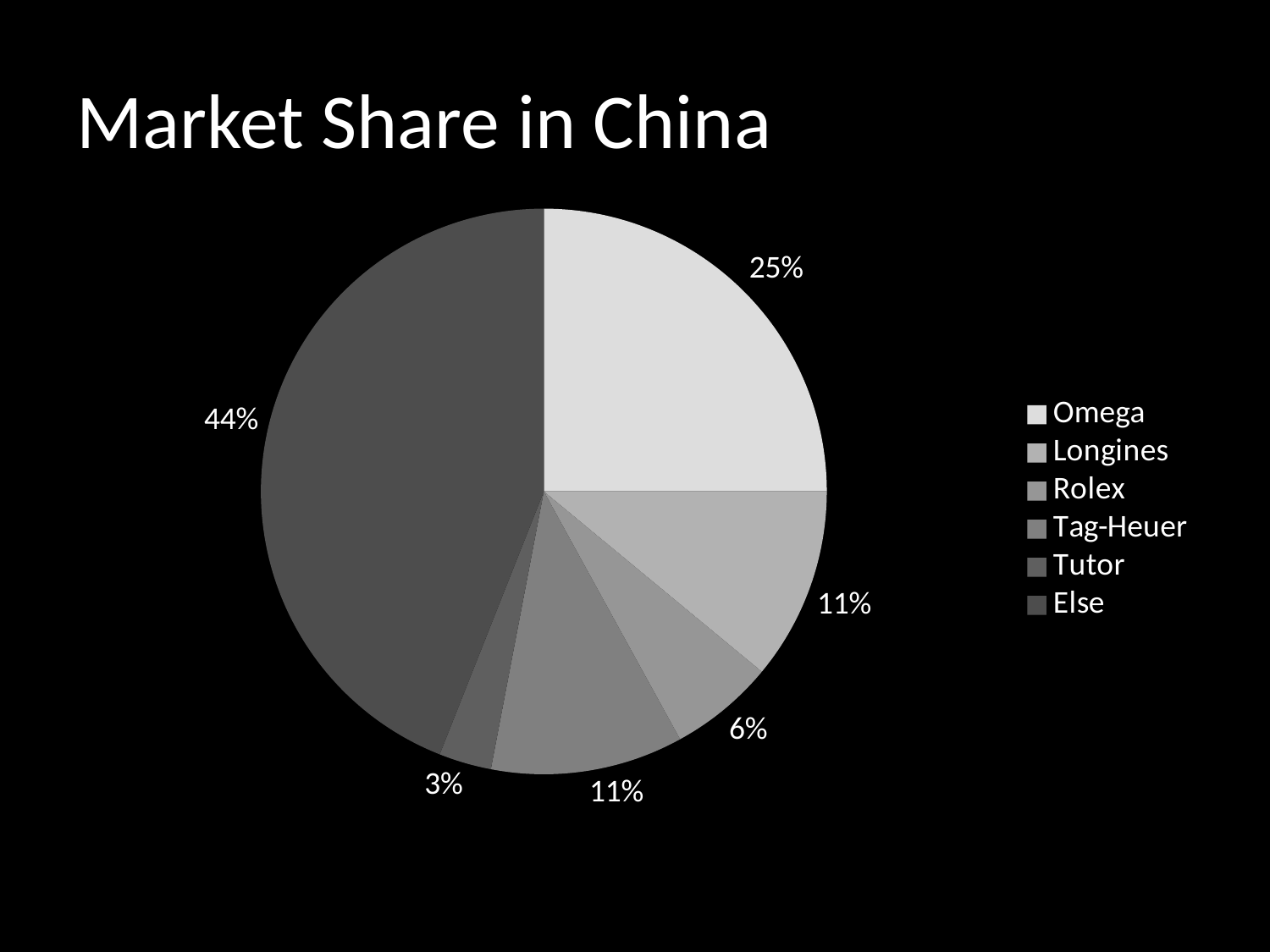
What share of the pie does Rolex hold? 6% What share of the pie does Else hold? 44% Which is larger, the share of Omega or the share of Tag-Heuer? Omega What share of the pie does Longines hold? 11% What is the difference between the shares of Omega and Rolex? 19% How many categories does the legend list? 6 Which category has the smallest slice of the pie? Tutor Which category has the largest slice of the pie? Else What is the title of the chart? Market Share in China What kind of chart is shown on the slide? pie chart